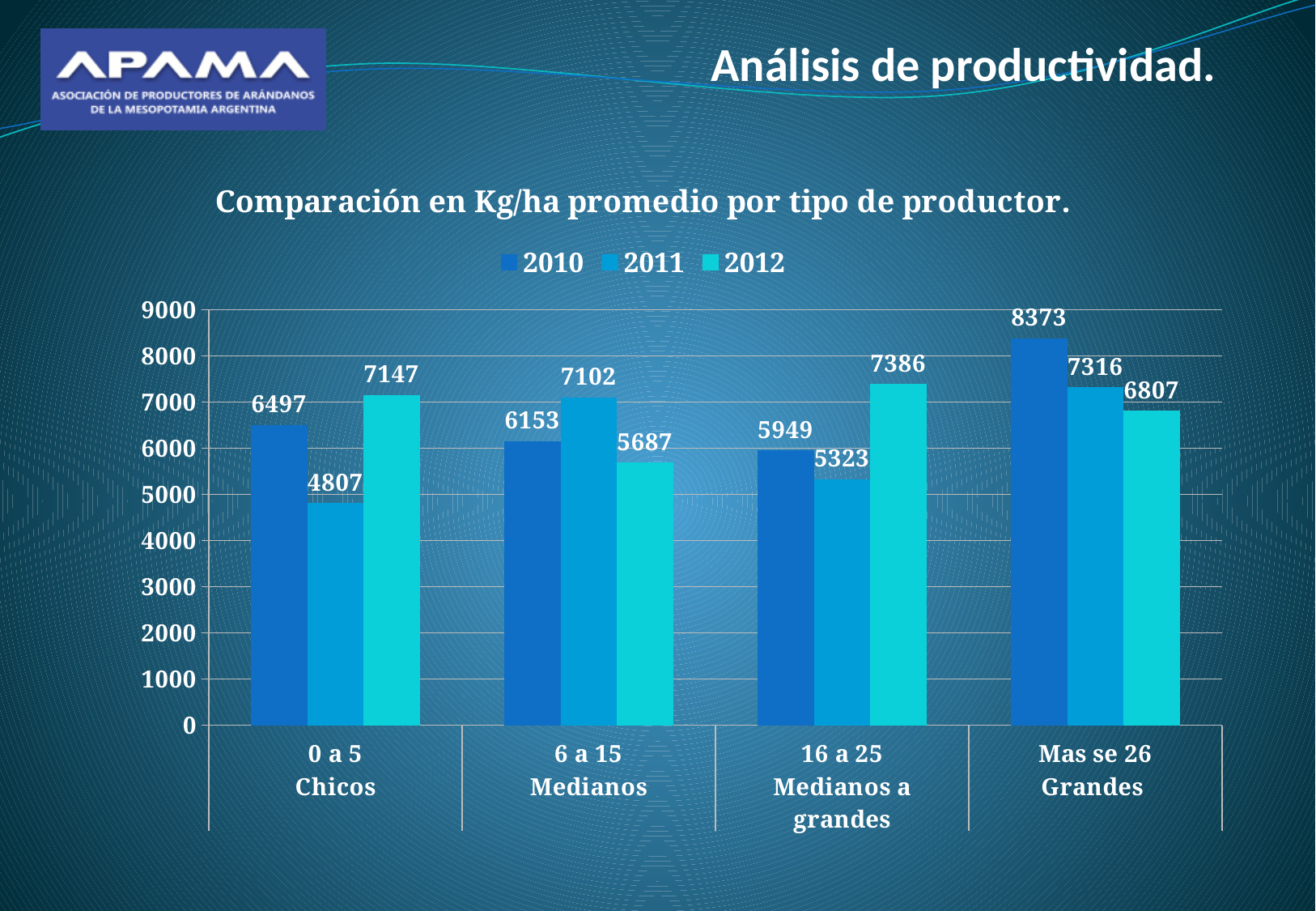
How many series does the legend list? 3 What is the 2012 value for the '16 a 25 Medianos a grandes' category? 7386 What is the title of the chart? Comparación en Kg/ha promedio por tipo de productor. What is the 2011 value for the 'Mas se 26 Grandes' category? 7316 Which category has the highest 2010 value? Mas se 26 Grandes Which category has the lowest 2011 value? 0 a 5 Chicos What is the difference between the 2012 and 2011 values for '0 a 5 Chicos'? 2340 What kind of chart is shown on the slide? bar chart What is the 2010 value for the '0 a 5 Chicos' category? 6497 Which is larger for '6 a 15 Medianos': the 2011 value or the 2012 value? 2011 How many producer categories are shown on the x axis? 4 Is the 2011 value for '16 a 25 Medianos a grandes' greater or less than 6000? less